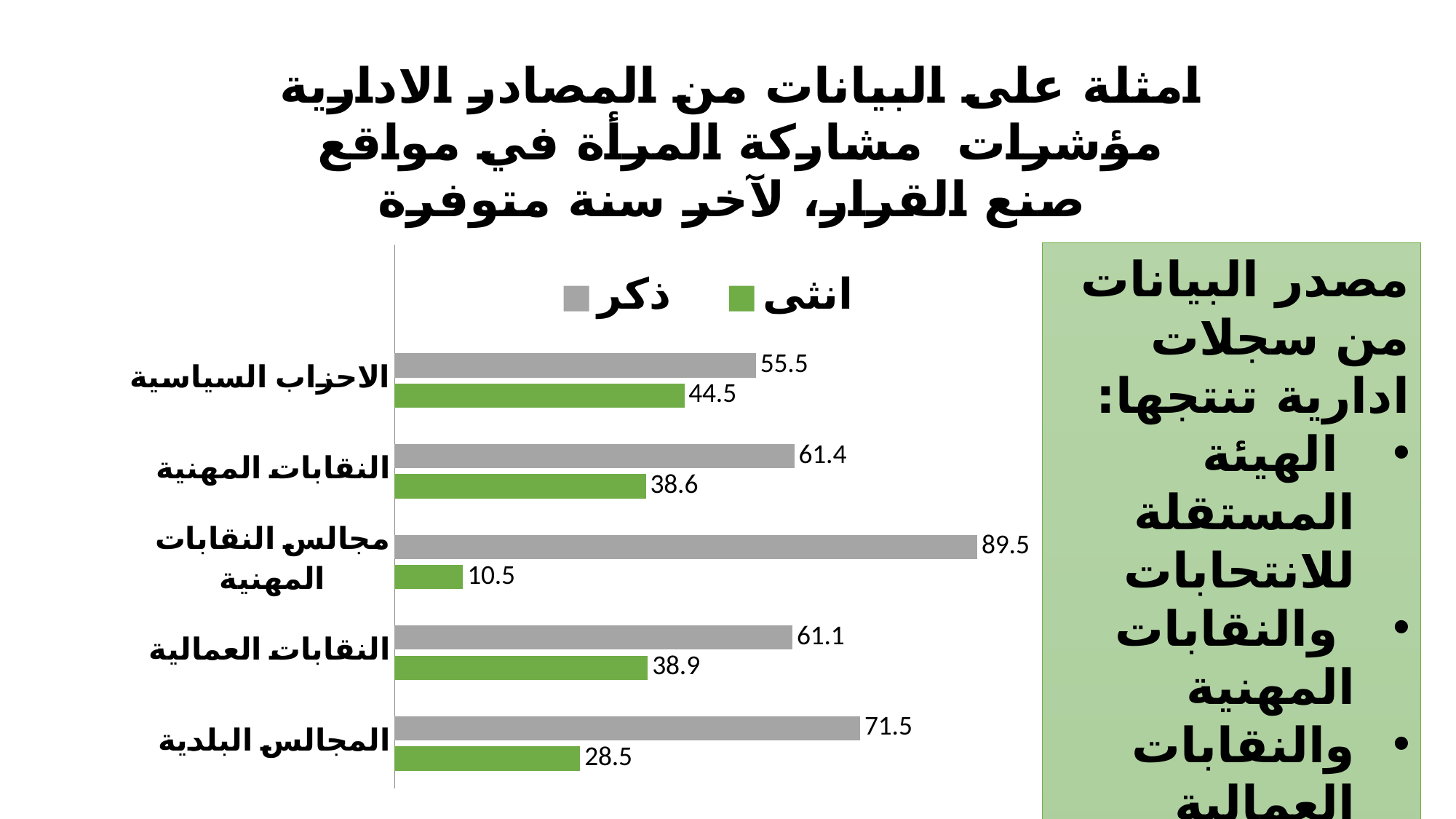
Which is larger: the انثى value for الاحزاب السياسية or the انثى value for المجالس البلدية? الاحزاب السياسية Which category has the lowest value for انثى (female)? مجالس النقابات المهنية What is the difference between the ذكر and انثى values in النقابات المهنية? 22.8 What is the value for انثى (female) in النقابات العمالية? 38.9 What type of chart is shown on the slide? bar chart What is the value for ذكر (male) in الاحزاب السياسية? 55.5 What is the value for انثى (female) in المجالس البلدية? 28.5 How many categories are shown on the chart? 5 Which colour represents the انثى (female) series in the chart? green Which category has the highest value for ذكر (male)? مجالس النقابات المهنية What is the total of the ذكر and انثى values for مجالس النقابات المهنية? 100 How many series does the legend list? 2